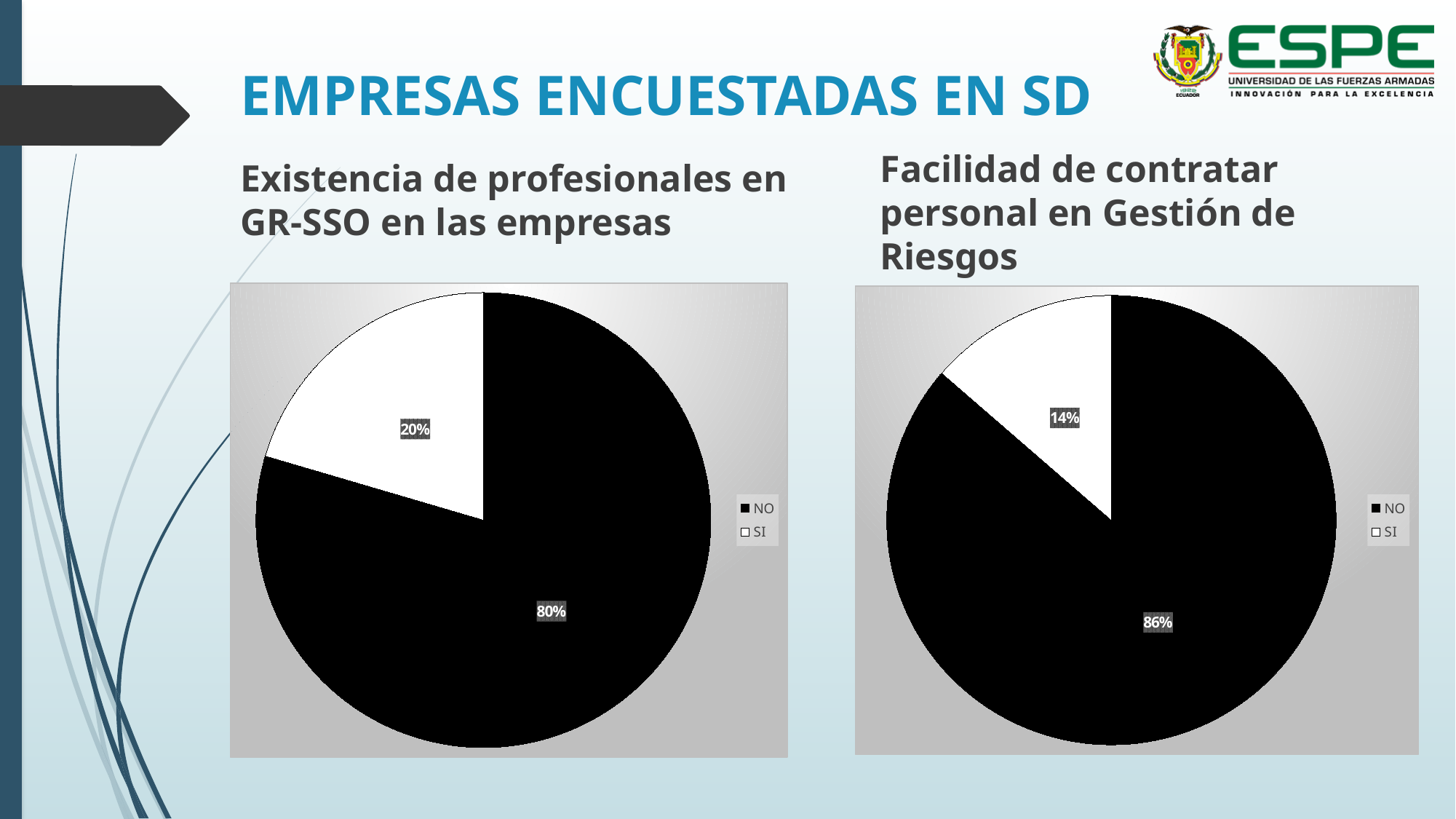
What kind of chart is the left chart? Pie chart In the left chart (Existencia de profesionales en GR-SSO en las empresas), what share of the pie is NO? 80% In the left chart, which slice is the largest? NO In the left chart, what colour is the SI slice? White In the left chart, what is the difference between the NO and SI shares? 60% In the right chart, which slice is the smallest? SI In the right chart, which is larger, NO or SI? NO In the right chart (Facilidad de contratar personal en Gestión de Riesgos), what share of the pie is SI? 14% In the right chart (Facilidad de contratar personal en Gestión de Riesgos), what share of the pie is NO? 86% In the right chart, what is the difference between the NO and SI shares? 72% How many slices does the right chart have? 2